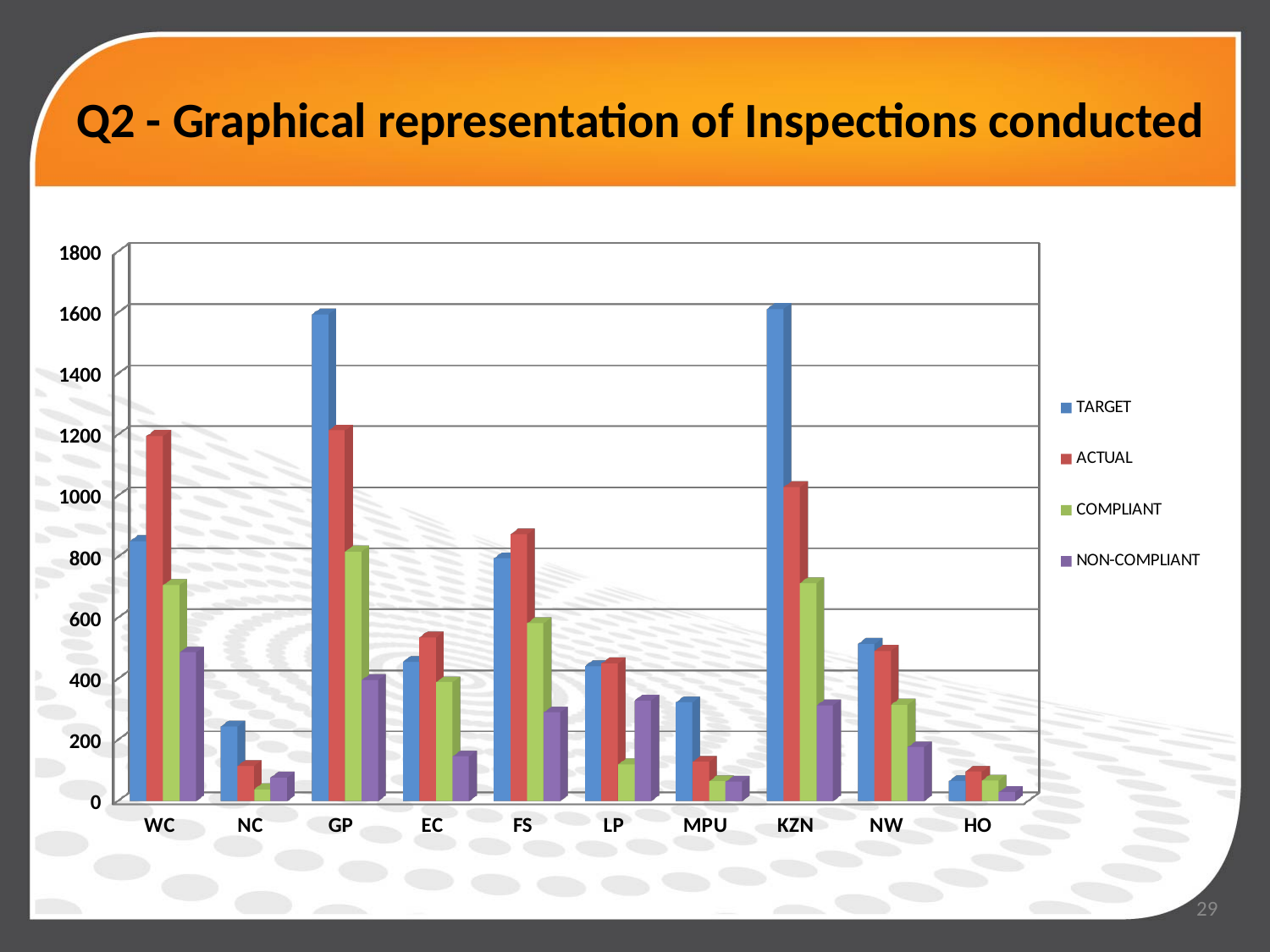
For KZN, which is larger, the TARGET value or the ACTUAL value? TARGET Which category has the lowest NON-COMPLIANT value? HO What is the title of the slide containing the chart? Q2 - Graphical representation of Inspections conducted Is the TARGET value for NC greater or less than 400? less Which category has the highest NON-COMPLIANT value? WC How many categories are shown on the x axis of the chart? 10 Is the TARGET value for GP greater or less than 1400? greater Which category has the lowest TARGET value? HO For WC, which is larger, the TARGET value or the ACTUAL value? ACTUAL How many series does the chart's legend list? 4 What kind of chart is shown on the slide? bar chart Which category has the highest COMPLIANT value? GP